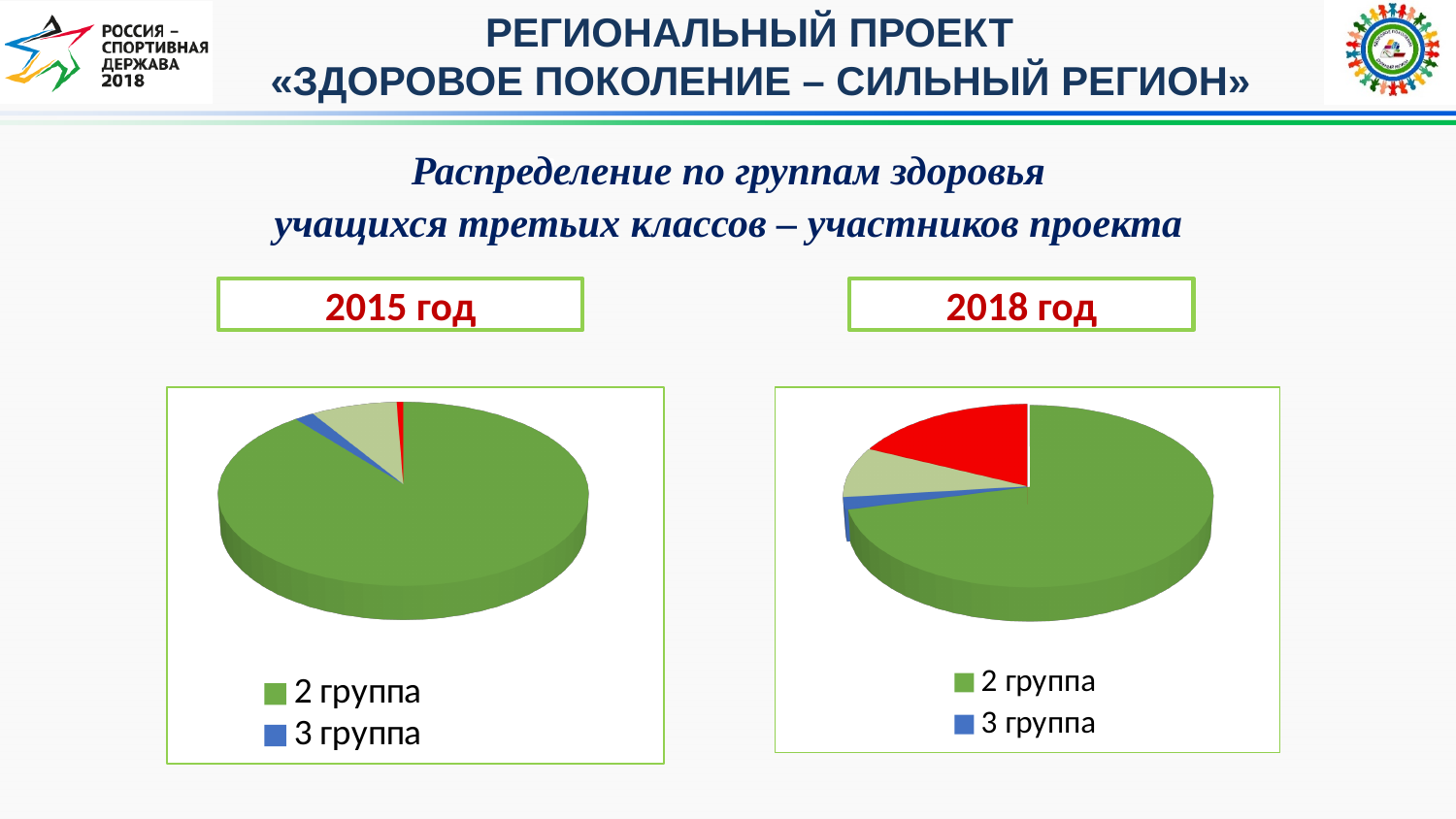
Which two years are compared by the pie charts on the slide? 2015 год and 2018 год How many slices are visible in the 2018 год pie chart? 4 In the 2018 год chart, what colour represents 2 группа? green What kind of chart is shown for 2015 год? pie chart In the 2015 год chart, which is larger: the slice for 2 группа or the slice for 3 группа? 2 группа In the 2015 год chart, which legend category has the largest slice? 2 группа What kind of chart is shown for 2018 год? pie chart In the 2018 год chart, which legend category has the largest slice? 2 группа How many entries does the legend of the 2015 год chart list? 2 How many entries does the legend of the 2018 год chart list? 2 In the 2018 год chart, which is larger: the slice for 2 группа or the slice for 3 группа? 2 группа